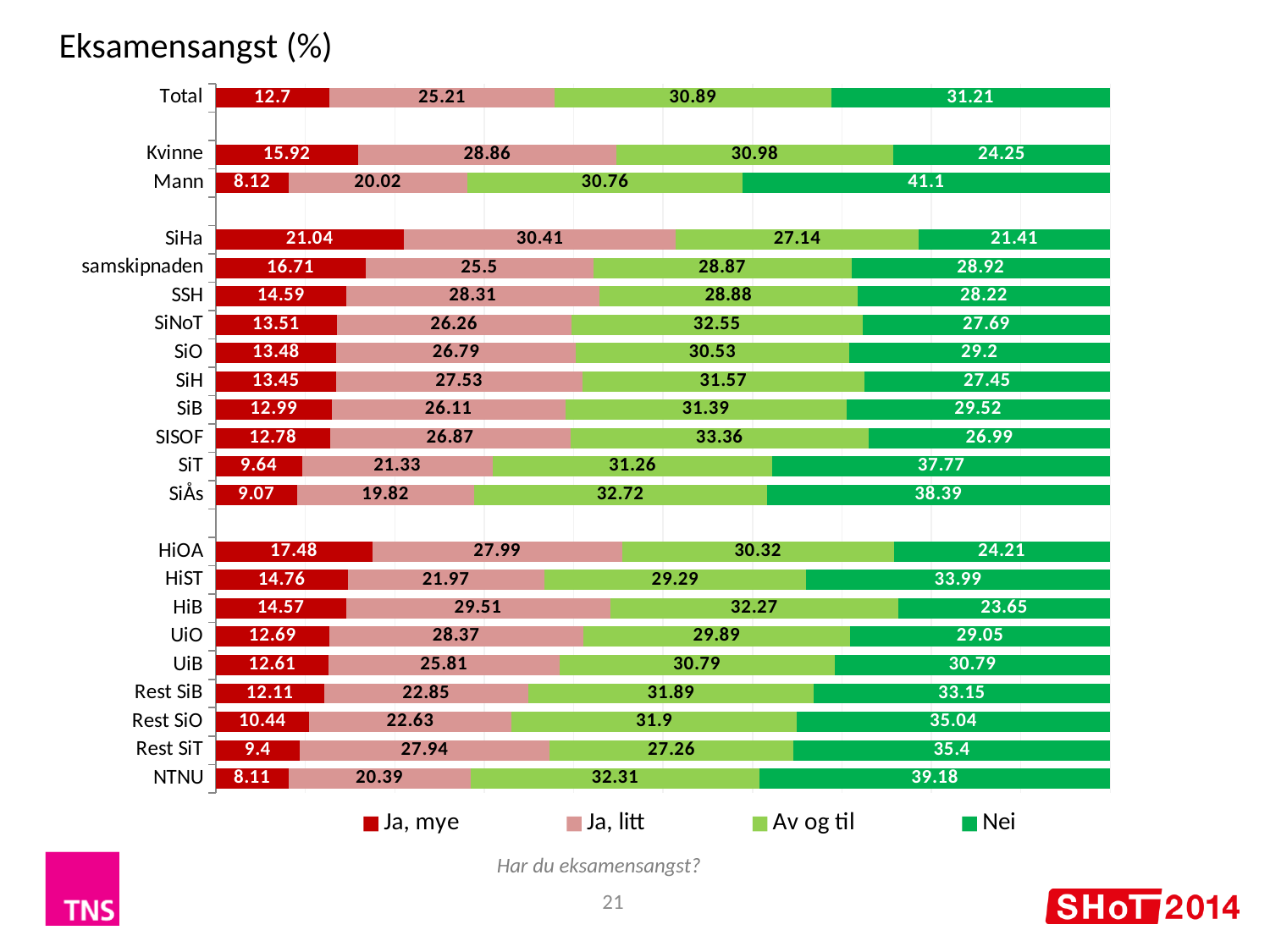
Which category has the highest value for "Nei"? Mann What is the value of "Ja, mye" for Total? 12.7 What is the value of "Ja, litt" for SiHa? 30.41 What is the total of the stacked bar for UiB? 100 How many series does the legend list? 4 What is the difference between the "Ja, mye" values for Kvinne and Mann? 7.8 What is the value of "Av og til" for NTNU? 32.31 Which category has the highest value for "Ja, mye"? SiHa Which category has the lowest value for "Nei"? SiHa What is the value of "Nei" for Mann? 41.1 Which has a larger "Ja, mye" value, HiOA or HiST? HiOA How many categories are shown on the chart? 22